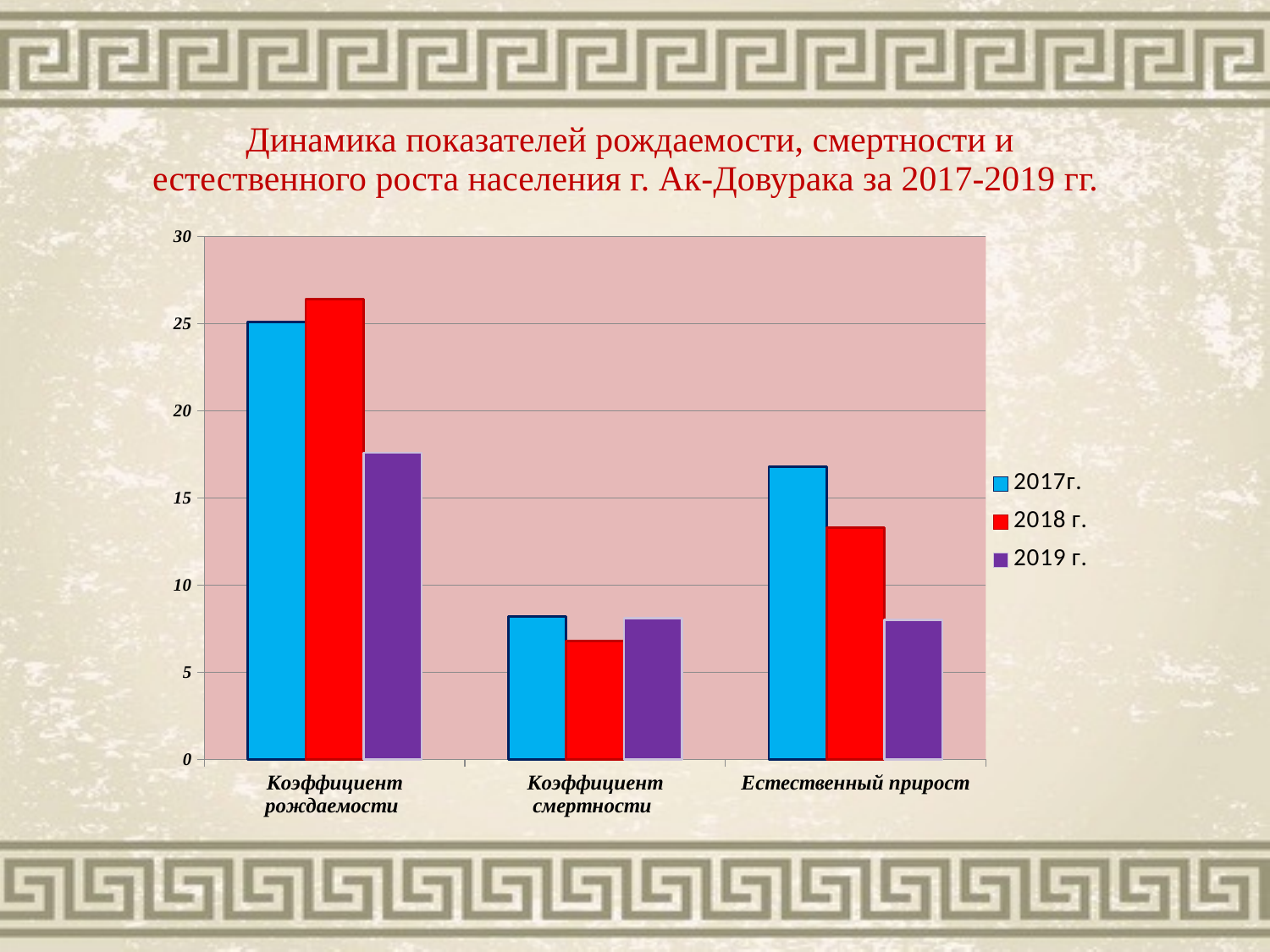
What kind of chart is shown on the slide? bar chart Which year has the lowest value for Естественный прирост? 2019 г. How many categories are shown on the x axis? 3 Which year has the highest value for Коэффициент рождаемости? 2018 г. Is the value for Коэффициент рождаемости in 2019 г. greater or less than 15? greater Is the value for Коэффициент рождаемости in 2018 г. greater or less than 25? greater Which is larger: Естественный прирост in 2017г. or in 2019 г.? 2017г. How many series does the legend list? 3 Is the value for Естественный прирост in 2018 г. greater or less than 15? less Do the values for Естественный прирост rise or fall from 2017 to 2019? fall Which year has the lowest value for Коэффициент смертности? 2018 г.